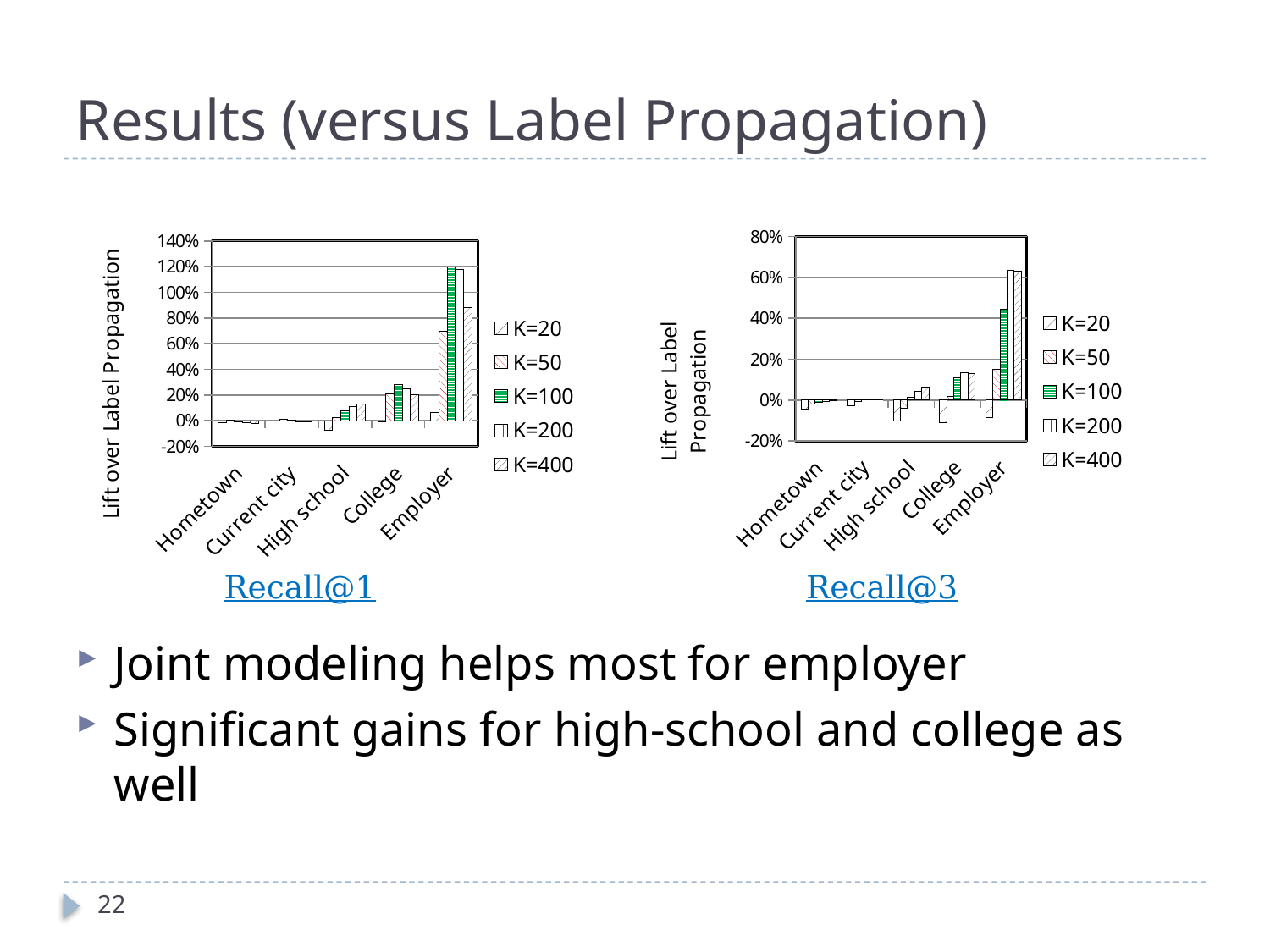
In the Recall@3 chart, which category has the highest lift over label propagation? Employer How many categories are shown on the x axis of the Recall@3 chart? 5 What is the y-axis label of the Recall@1 chart? Lift over Label Propagation In the Recall@1 chart, which is larger at K=200: the value for Employer or the value for College? Employer In the Recall@3 chart, is the value for Employer at K=200 greater or less than 40%? greater What kind of chart is the Recall@1 chart on the left? bar chart In the Recall@3 chart, do the values generally rise or fall moving from Hometown to Employer along the x axis? rise How many series does the legend of the Recall@1 chart list? 5 In the Recall@1 chart, is the value for College at K=100 greater or less than 40%? less In the Recall@1 chart, which category has the highest lift over label propagation? Employer In the Recall@1 chart, is the value for Employer at K=100 greater or less than 100%? greater